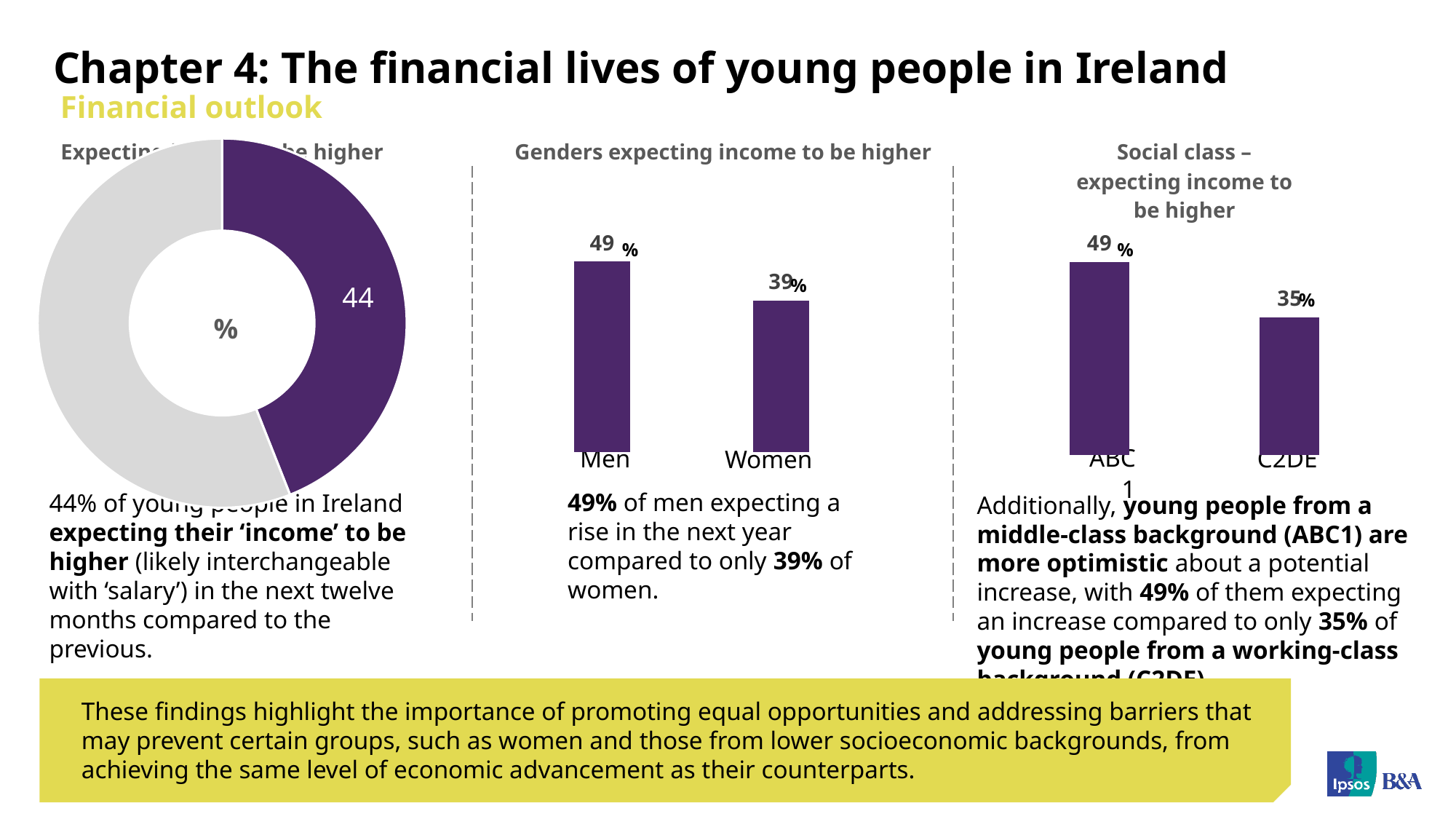
In the chart titled 'Social class – expecting income to be higher', what is the difference between the values for ABC1 and C2DE? 14% In the chart titled 'Genders expecting income to be higher', which category has the higher value? Men In the chart titled 'Social class – expecting income to be higher', what is the value for ABC1? 49% In the chart titled 'Genders expecting income to be higher', what is the difference between the values for Men and Women? 10% In the chart titled 'Social class – expecting income to be higher', which category has the lower value? C2DE In the chart titled 'Genders expecting income to be higher', how many categories are shown? 2 In the chart titled 'Social class – expecting income to be higher', what is the value for C2DE? 35% What kind of chart is the chart titled 'Social class – expecting income to be higher'? Bar chart In the chart titled 'Genders expecting income to be higher', what is the value for Men? 49% In the donut chart on the left of the slide, what value is printed on the purple segment? 44 In the chart titled 'Genders expecting income to be higher', what is the value for Women? 39% What kind of chart is the chart on the left of the slide? Donut chart